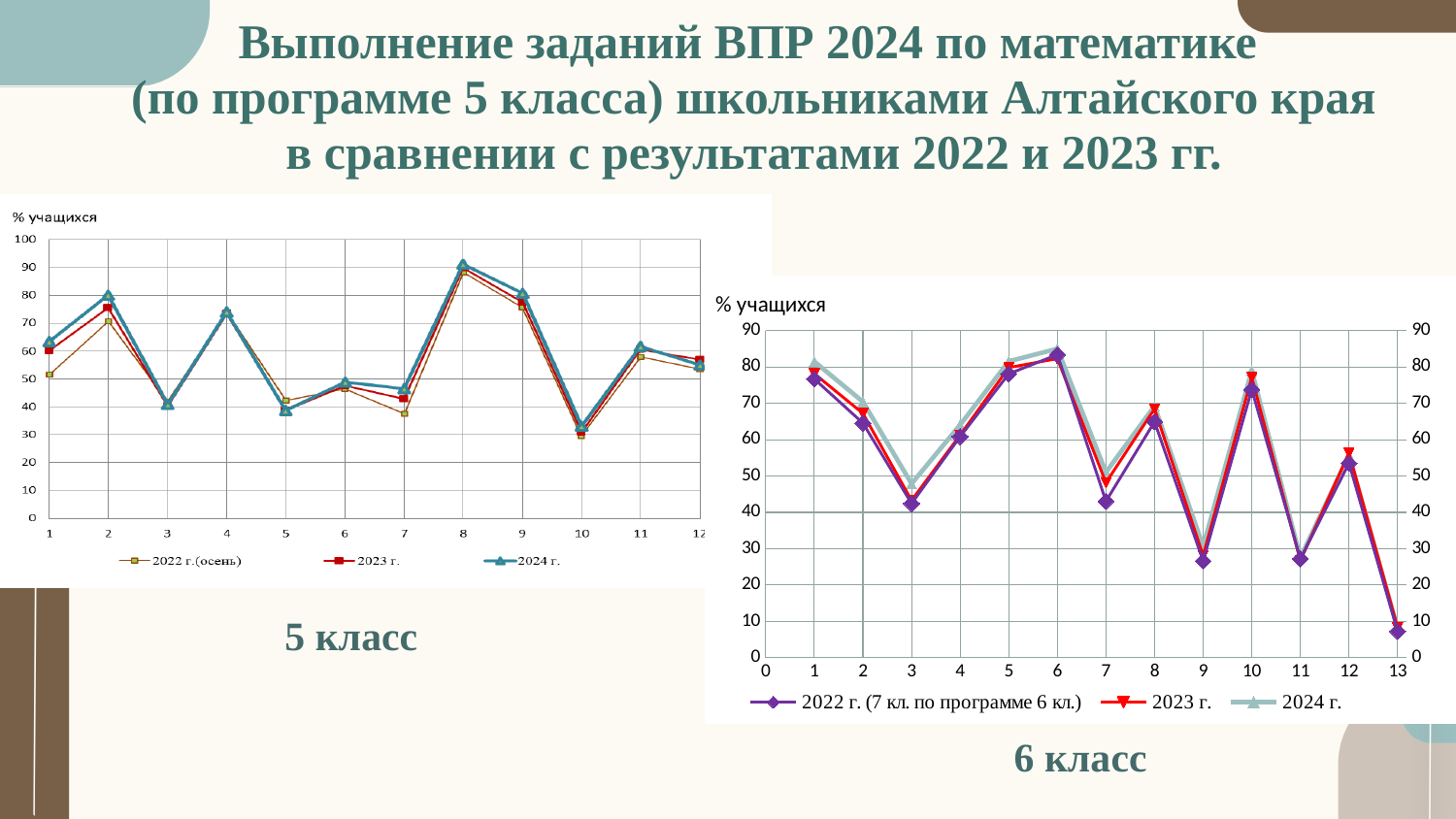
In the '6 класс' chart on the right, is the 2024 г. value for task 13 greater or less than 20? less How many task numbers are plotted along the x axis of the '6 класс' chart on the right? 13 In the '6 класс' chart on the right, do the 2022 г. values rise or fall from task 3 to task 6? rise In the '5 класс' chart on the left, which task has the highest value for the 2024 г. series? 8 In the '6 класс' chart on the right, which task has the lowest value for the 2022 г. series? 13 How many series does the legend of the '6 класс' chart on the right list? 3 What kind of chart is the '5 класс' chart on the left? line chart In the '5 класс' chart on the left, which task has the lowest value for the 2024 г. series? 10 In the '6 класс' chart on the right, is the 2022 г. value for task 3 greater or less than 50? less In the '6 класс' chart on the right, which is larger for the 2023 г. series: task 1 or task 2? task 1 In the '5 класс' chart on the left, is the 2024 г. value for task 8 greater or less than 80? greater How many task numbers are plotted along the x axis of the '5 класс' chart on the left? 12